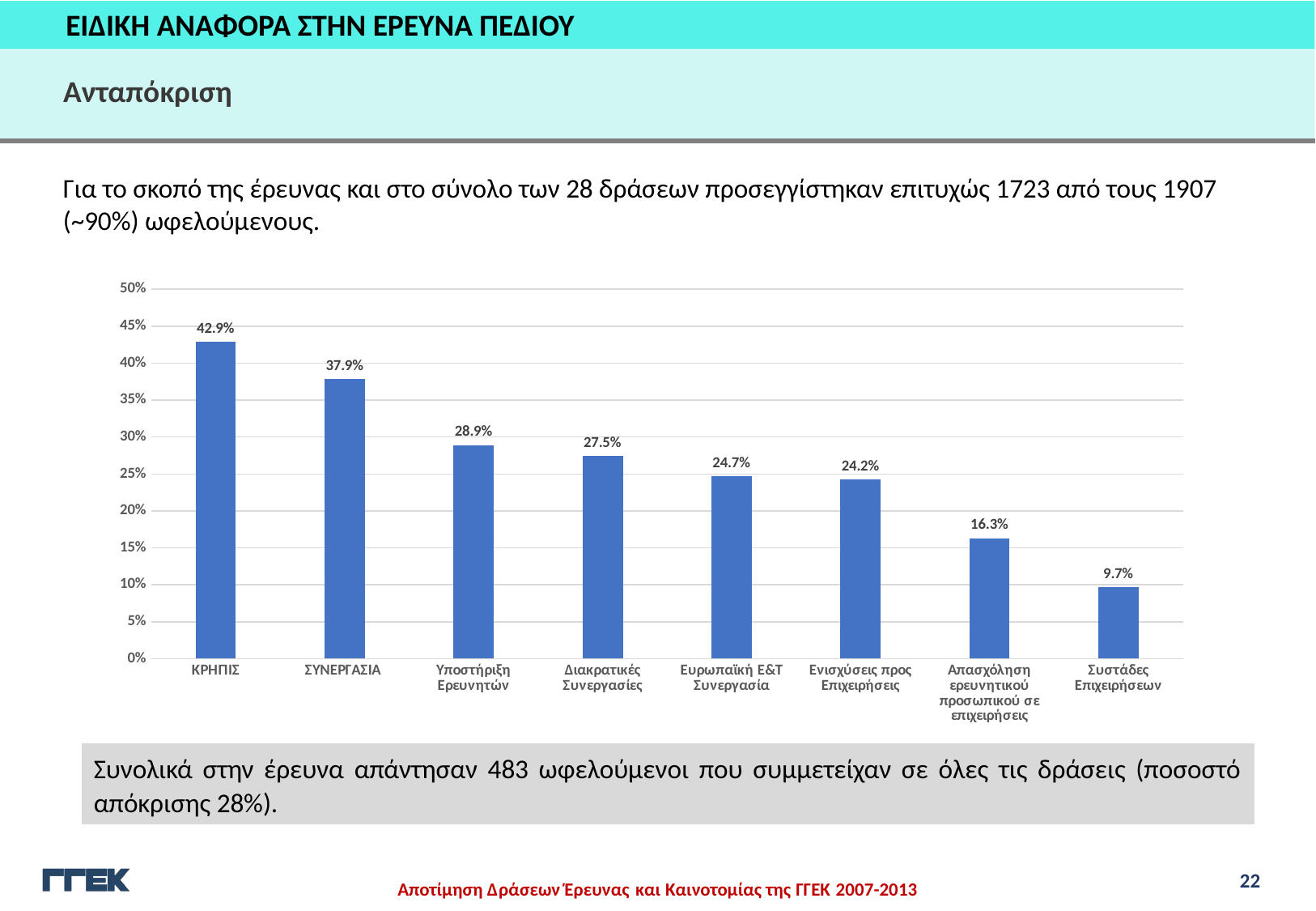
Is the value for ΣΥΝΕΡΓΑΣΙΑ greater or less than 35%? greater What is the value for Συστάδες Επιχειρήσεων? 9.7% What kind of chart is shown on the slide? bar chart Do the values rise or fall from left to right along the x axis? fall Which is larger, the value for Διακρατικές Συνεργασίες or the value for Απασχόληση ερευνητικού προσωπικού σε επιχειρήσεις? Διακρατικές Συνεργασίες Which category has the highest value? ΚΡΗΠΙΣ What is the maximum value shown on the y axis? 50% How many categories are shown in the chart? 8 Which category has the lowest value? Συστάδες Επιχειρήσεων What is the difference between the values for ΚΡΗΠΙΣ and ΣΥΝΕΡΓΑΣΙΑ? 5.0% What is the value for ΚΡΗΠΙΣ? 42.9% What is the value for Υποστήριξη Ερευνητών? 28.9%